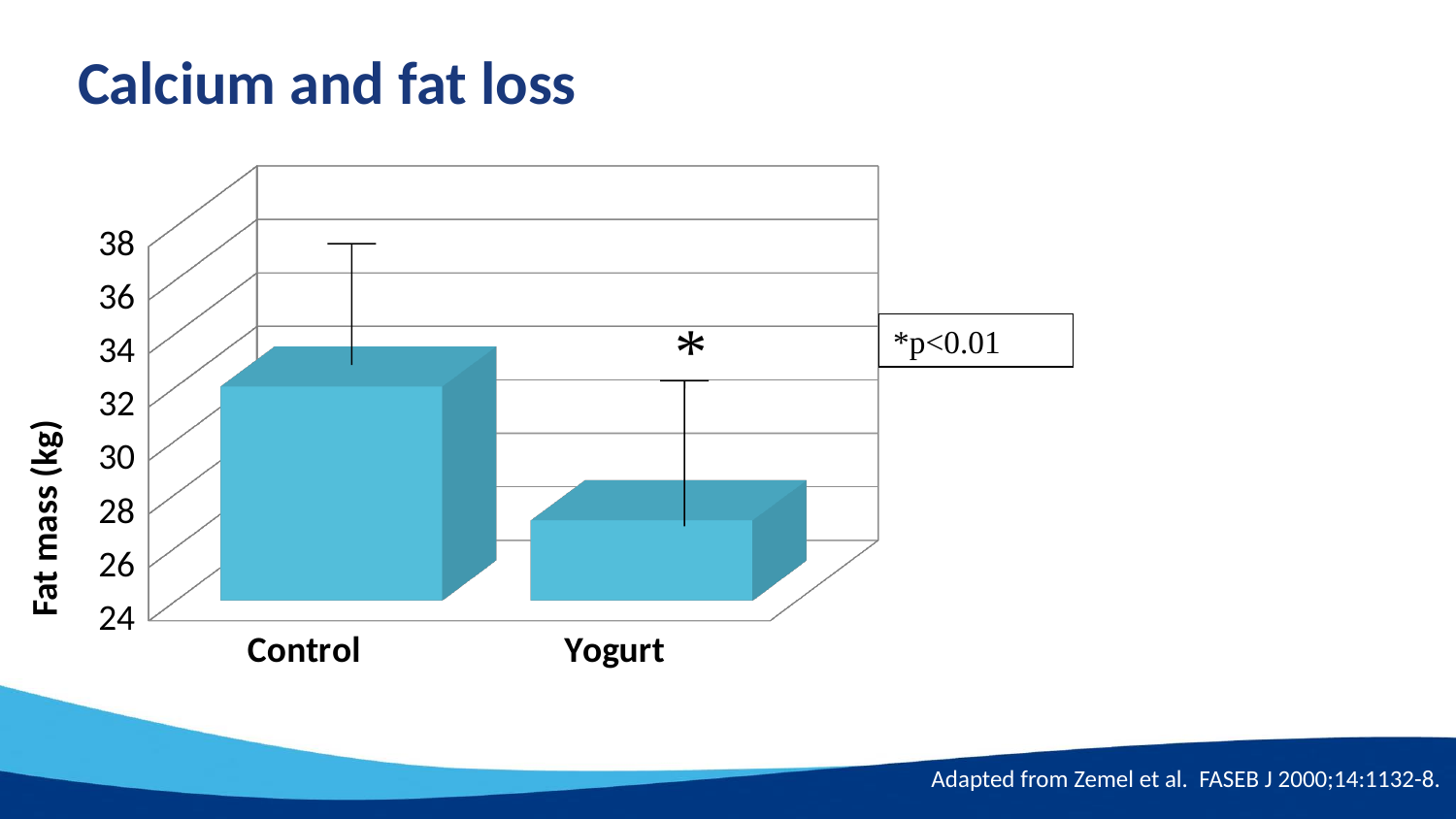
What kind of chart is shown on the slide? bar chart How many categories are plotted on the x axis? 2 What is the label of the y axis? Fat mass (kg) Is the value for Control greater or less than 30? greater Do the values rise or fall from Control to Yogurt along the x axis? fall Which category has the lowest fat mass? Yogurt Which category has the highest fat mass? Control Which is larger, the fat mass for Control or for Yogurt? Control Is the value for Yogurt greater or less than 30? less Is the value for Control greater or less than 36? less What significance note is printed in the box next to the chart? *p<0.01